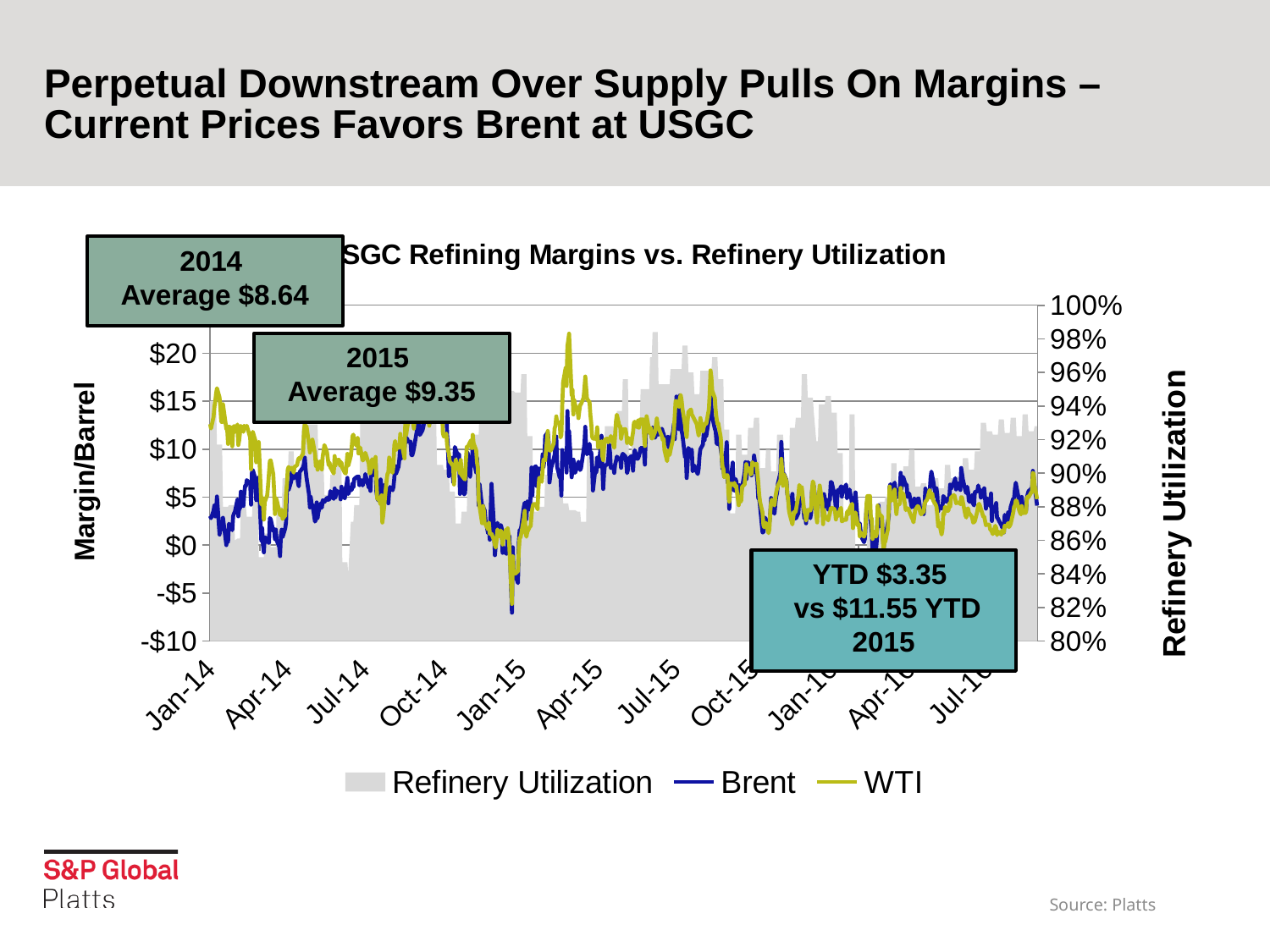
What is the difference between the 2015 average and the 2014 average margin? $0.71 What is the YTD margin shown in the annotation on the chart? $3.35 Is the peak value of the WTI line around Apr-15 greater or less than $20? greater Which annual average margin is larger, 2014 or 2015? 2015 What was the 2014 average margin according to the annotation on the chart? $8.64 Is the lowest value of the Brent line around Jan-15 greater or less than -$5? less What kind of chart is shown on the slide? line chart How many series does the legend list? 3 What was the YTD 2015 margin shown in the annotation on the chart? $11.55 What is the difference between the YTD 2015 margin ($11.55) and the current YTD margin ($3.35)? $8.20 What was the 2015 average margin according to the annotation on the chart? $9.35 Which colour is used for the Brent series in the legend? blue